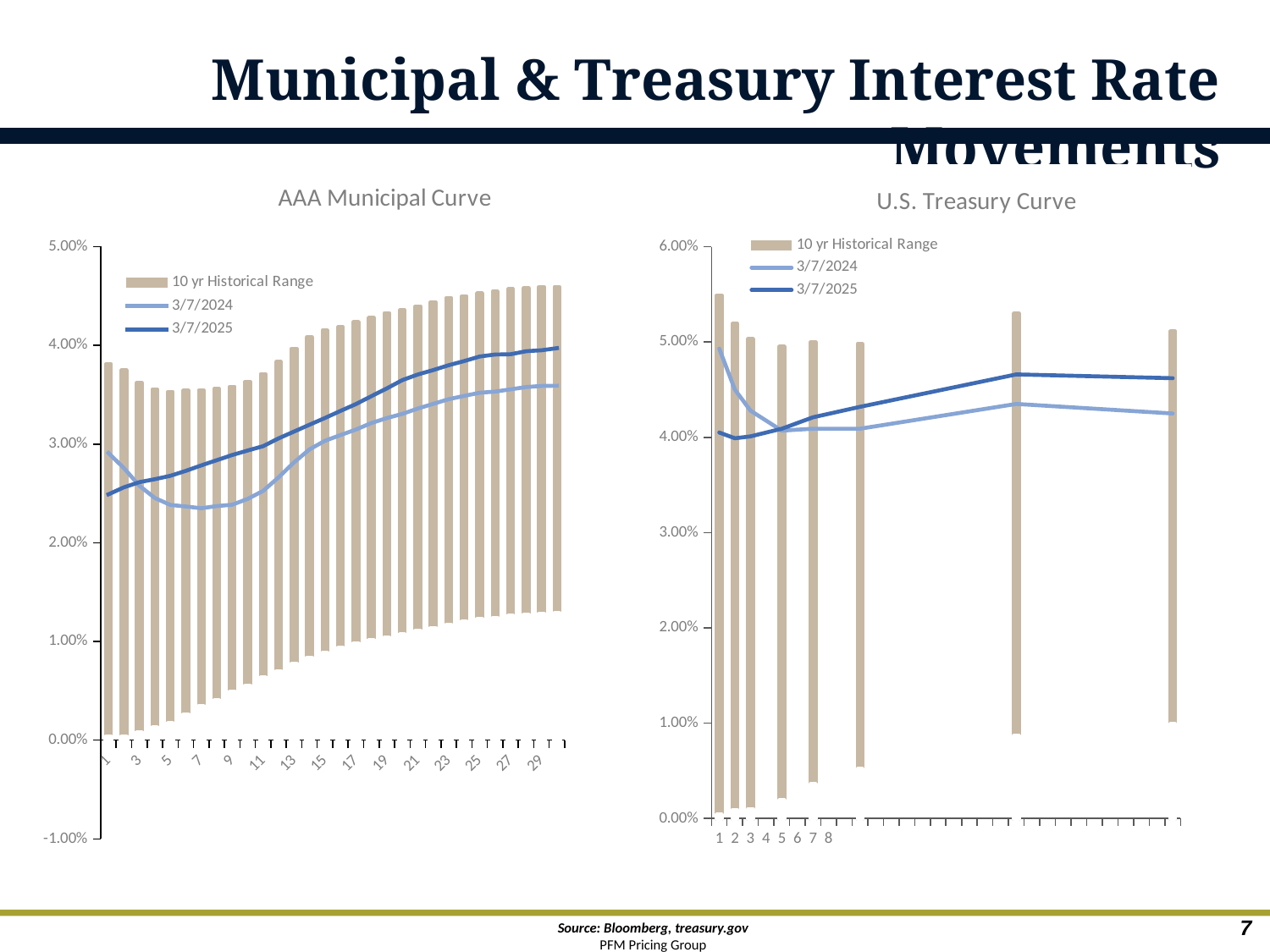
On the AAA Municipal Curve chart, at point 29, which line is higher: 3/7/2024 or 3/7/2025? 3/7/2025 On the U.S. Treasury Curve chart, is the top of the 10 yr Historical Range bar at point 1 greater or less than 5.00%? greater What are the three legend entries on the U.S. Treasury Curve chart? 10 yr Historical Range, 3/7/2024, 3/7/2025 How many series does the legend of the AAA Municipal Curve chart list? 3 What is the title of the chart on the left side of the slide? AAA Municipal Curve On the AAA Municipal Curve chart, at point 1, which line is higher: 3/7/2024 or 3/7/2025? 3/7/2024 On the U.S. Treasury Curve chart, is the 3/7/2024 value at point 1 greater or less than 4.00%? greater On the AAA Municipal Curve chart, is the 3/7/2025 value at point 1 greater or less than 2.00%? greater On the U.S. Treasury Curve chart, at the last point on the right, which line is higher: 3/7/2024 or 3/7/2025? 3/7/2025 How many series does the legend of the U.S. Treasury Curve chart list? 3 On the AAA Municipal Curve chart, does the 3/7/2025 line generally rise or fall as the x axis increases? rise